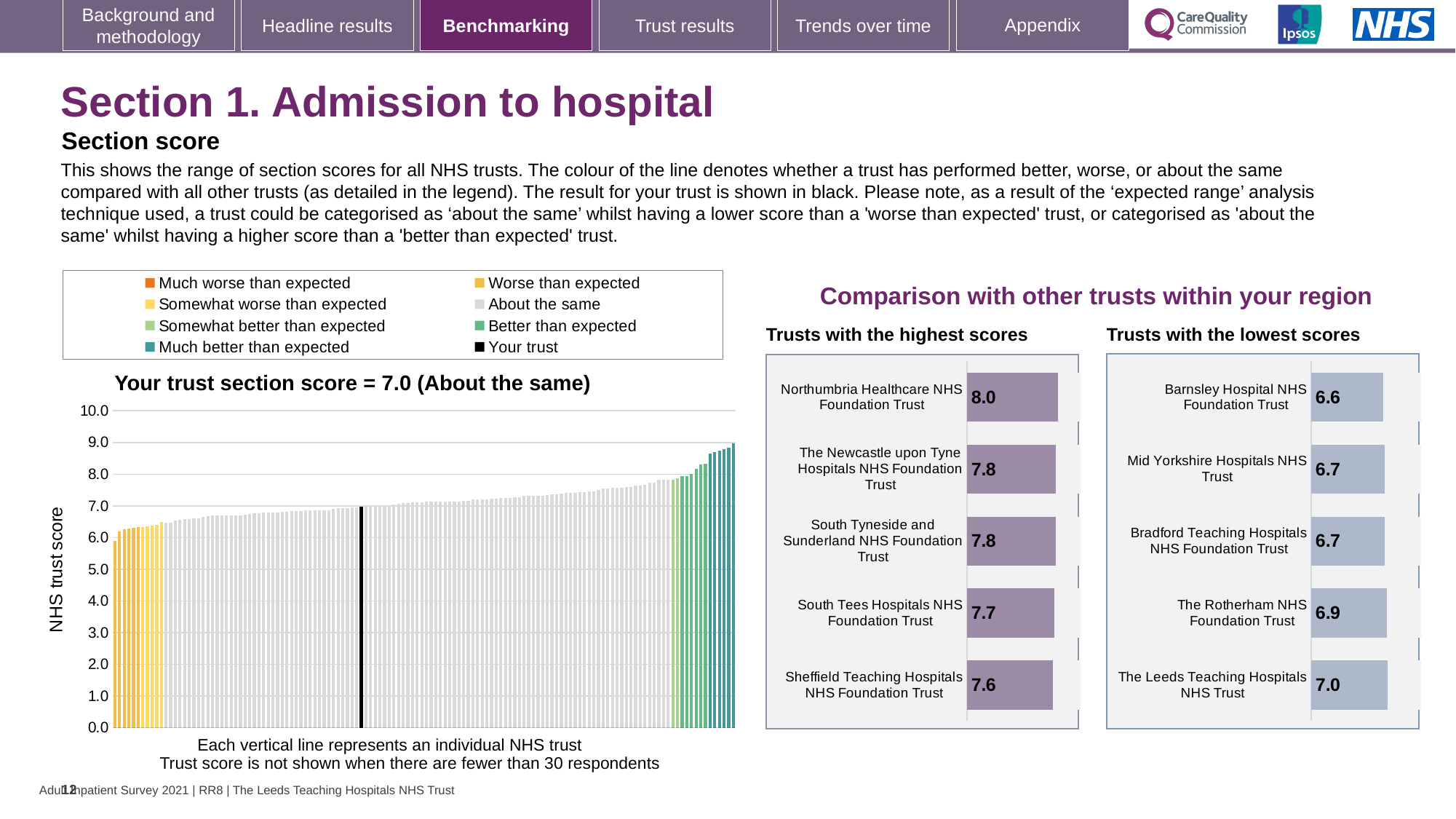
In the 'Your trust section score' chart, how many entries does the legend list? 8 In the 'Your trust section score' chart, is the value of the rightmost (highest) bar greater or less than 8.0? greater In the 'Trusts with the highest scores' chart, which trust has the lowest score? Sheffield Teaching Hospitals NHS Foundation Trust In the 'Your trust section score' chart, what is the section score for your trust? 7.0 In the 'Your trust section score' chart, do the trust scores rise or fall from left to right along the x axis? Rise In the 'Trusts with the highest scores' chart, what is the score for Northumbria Healthcare NHS Foundation Trust? 8.0 In the 'Trusts with the lowest scores' chart, which trust has the highest score? The Leeds Teaching Hospitals NHS Trust In the 'Trusts with the highest scores' chart, how many trusts are shown? 5 In the 'Trusts with the highest scores' chart, what is the difference between the scores of Northumbria Healthcare NHS Foundation Trust and Sheffield Teaching Hospitals NHS Foundation Trust? 0.4 What kind of chart is the 'Your trust section score' chart? Bar chart In the 'Trusts with the lowest scores' chart, which has the larger score: The Rotherham NHS Foundation Trust or Barnsley Hospital NHS Foundation Trust? The Rotherham NHS Foundation Trust In the 'Trusts with the lowest scores' chart, what is the score for Barnsley Hospital NHS Foundation Trust? 6.6